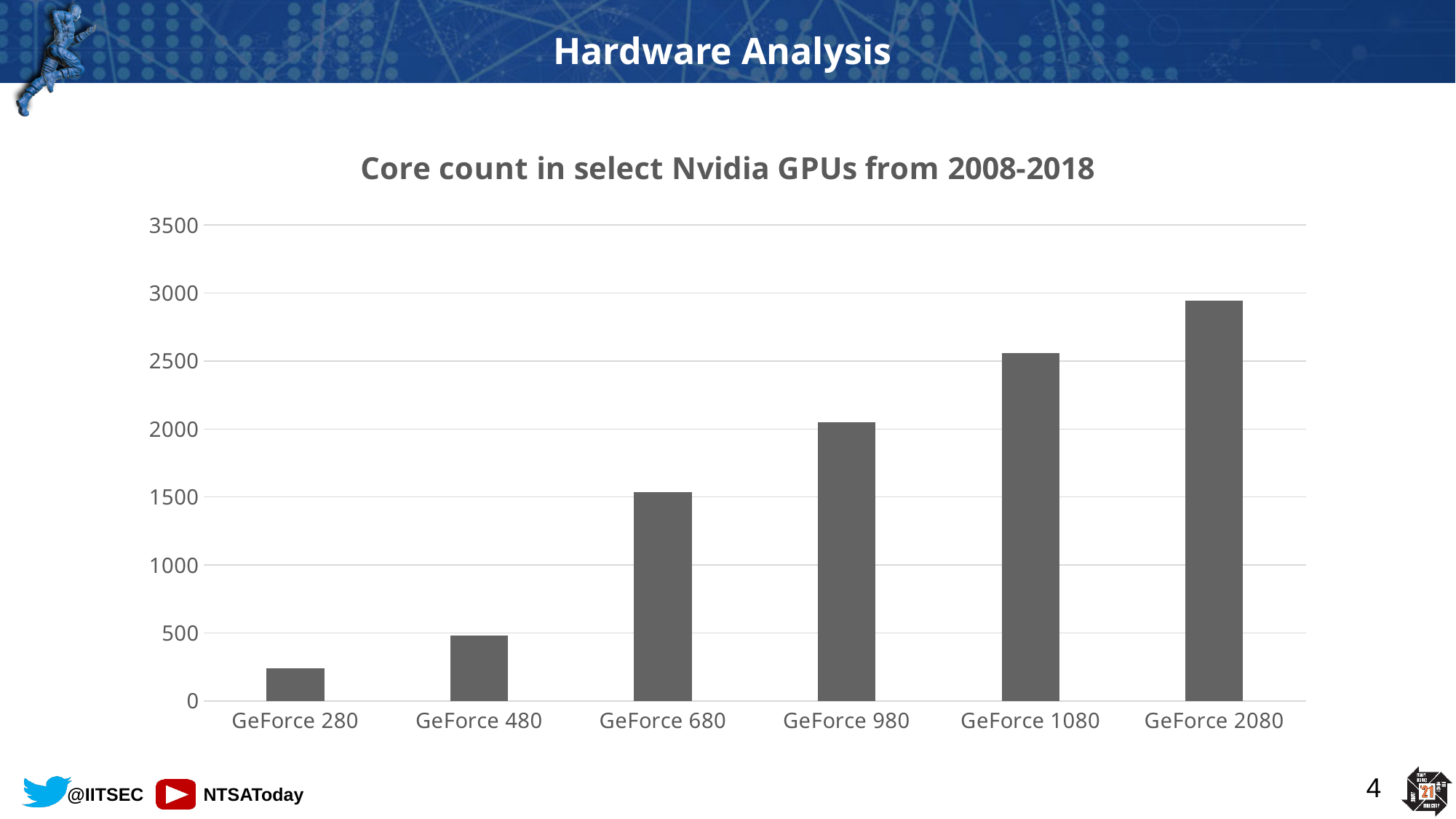
Which GPU has the lowest core count in the chart? GeForce 280 Is the value for GeForce 680 greater or less than 1000? greater Which GPU has the highest core count in the chart? GeForce 2080 Is the value for GeForce 1080 greater or less than 2000? greater Which has a higher core count, GeForce 680 or GeForce 980? GeForce 980 Is the value for GeForce 280 greater or less than 500? less What is the title of the chart? Core count in select Nvidia GPUs from 2008-2018 What kind of chart is shown on the slide? bar chart Do the core counts rise or fall from GeForce 280 to GeForce 2080 along the x axis? rise Which has a lower core count, GeForce 1080 or GeForce 480? GeForce 480 How many GPUs are shown on the x axis of the chart? 6